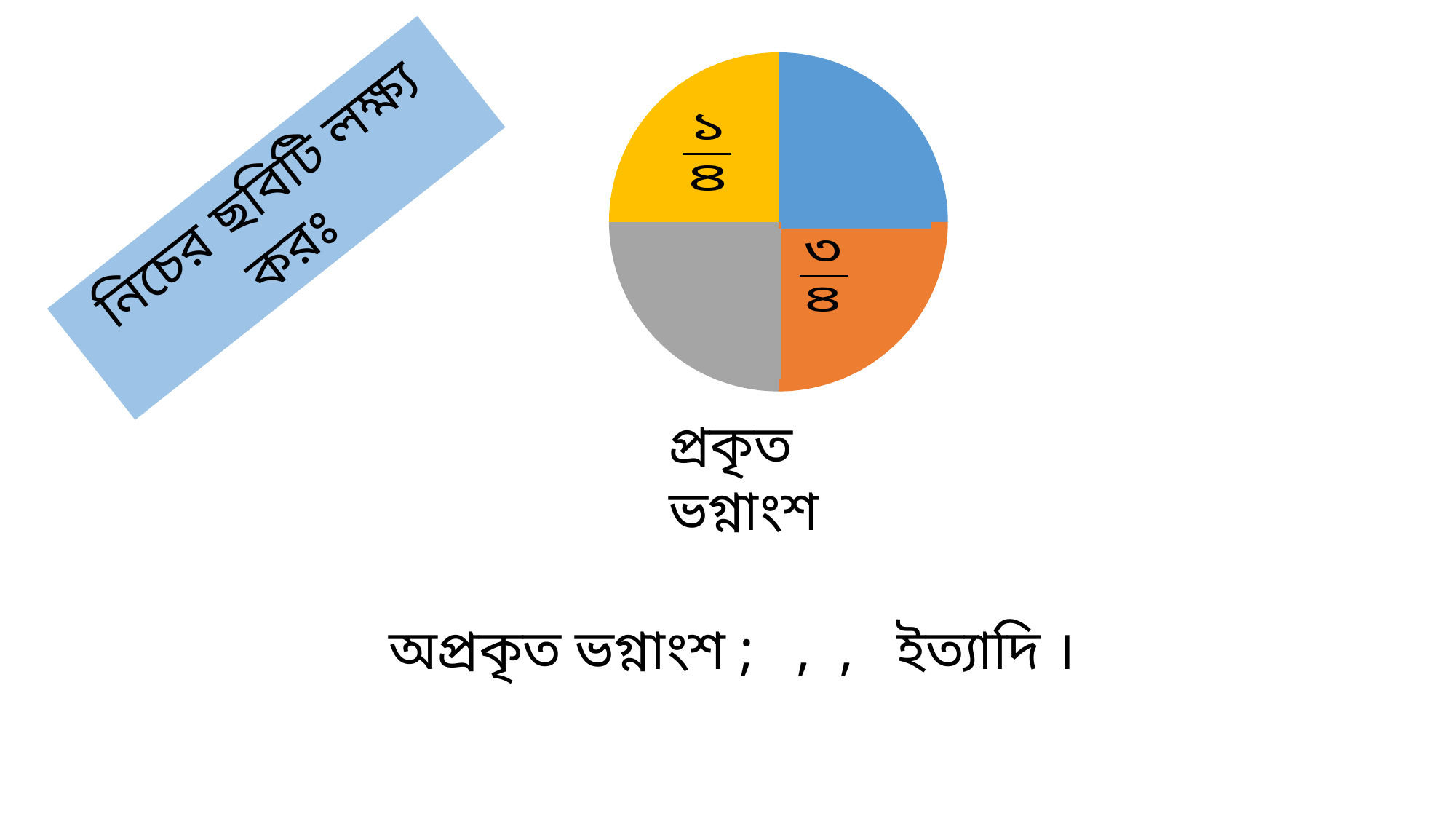
What label is printed on the yellow slice of the pie chart? ১/৪ What colour is the slice in the top-right quarter of the pie chart? blue How many slices does the pie chart have? 4 What label is printed on the orange slice of the pie chart? ৩/৪ What text appears directly below the pie chart? প্রকৃত ভগ্নাংশ What kind of chart is shown on the slide? pie chart